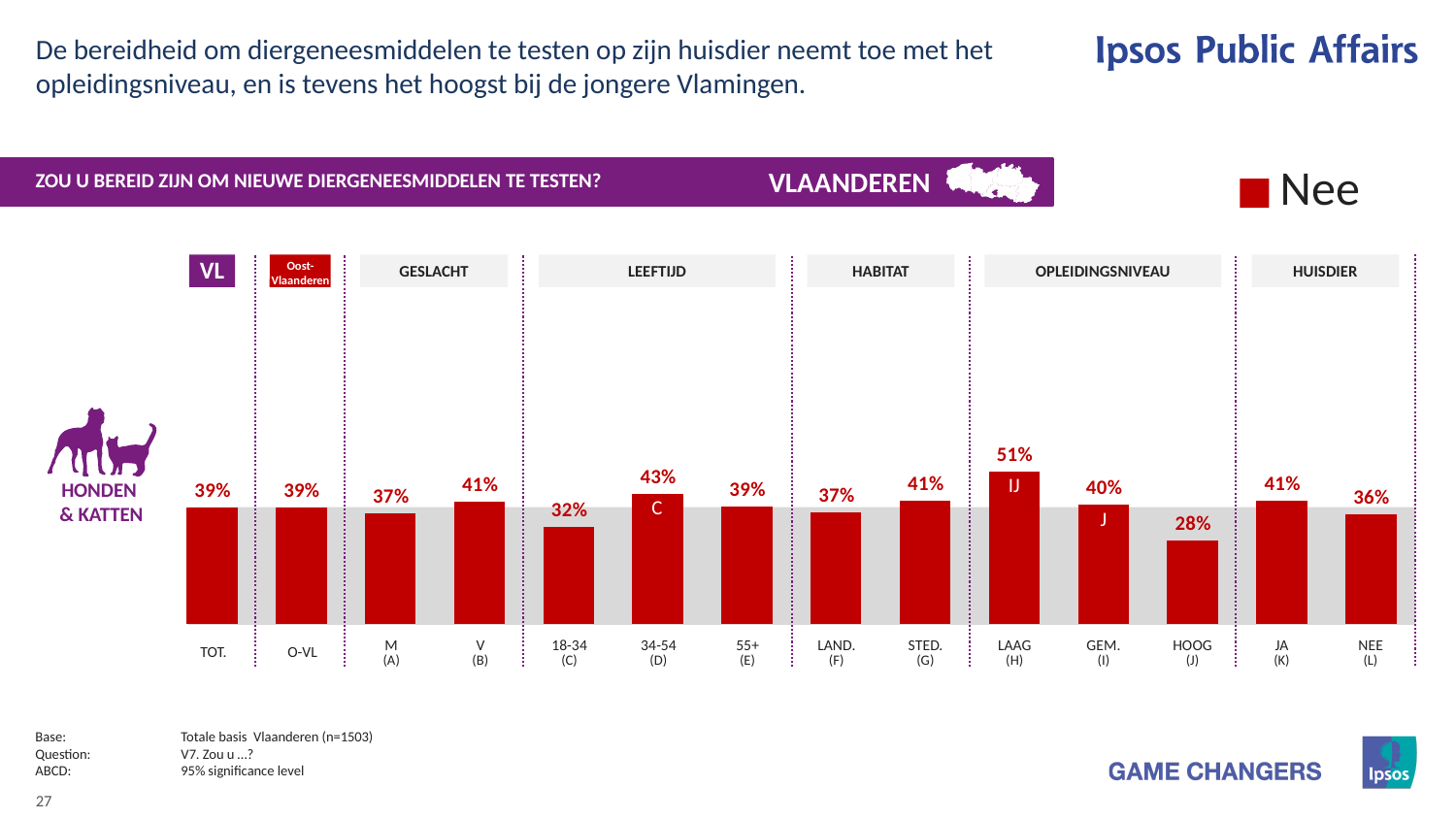
What is the difference between the values for 34-54 (D) and 18-34 (C)? 11% What is the value for the 18-34 (C) age group? 32% Which category has the lowest value in the chart? HOOG (J) What kind of chart is shown on the slide? Bar chart Which is larger, the value for M (A) or the value for V (B)? V (B) Which category has the highest value in the chart? LAAG (H) What is the value for HOOG (J) under OPLEIDINGSNIVEAU? 28% What is the value for TOT. (total) in the chart? 39% How many series does the legend list? 1 What is the value for LAAG (H) under OPLEIDINGSNIVEAU? 51% How many bars are plotted in the chart? 14 What is the difference between the values for LAAG (H) and HOOG (J)? 23%